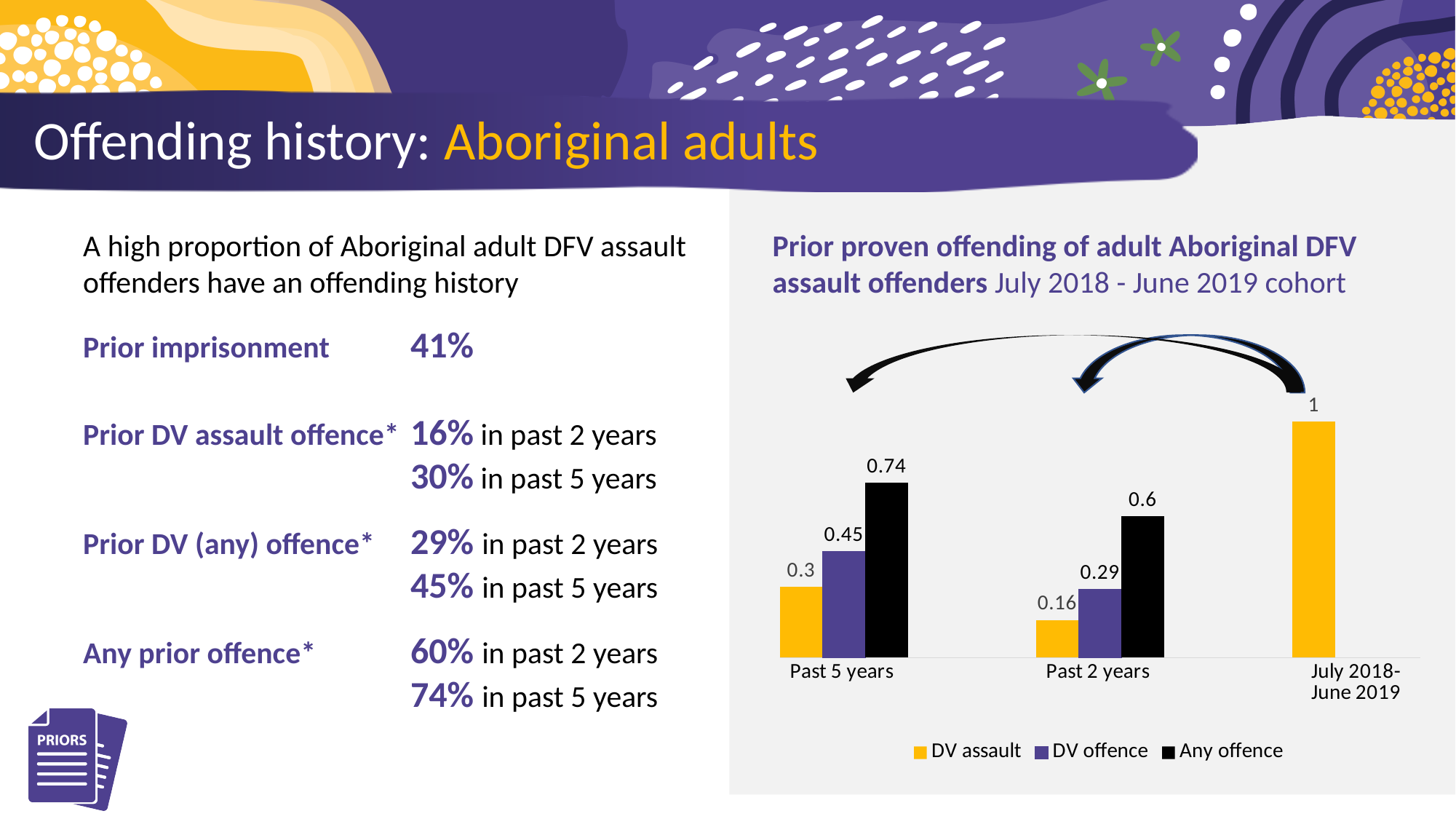
What colour represents the DV assault series in the chart? yellow Which is larger: DV offence in Past 5 years or Any offence in Past 2 years? Any offence in Past 2 years Which series has the highest value in the Past 2 years category? Any offence What is the value for DV assault in the Past 2 years category? 0.16 What is the value for DV offence in the Past 5 years category? 0.45 What is the difference between the Any offence values for Past 5 years and Past 2 years? 0.14 How many categories are shown on the x axis of the chart? 3 What is the value for Any offence in the Past 5 years category? 0.74 Which series has the lowest value in the Past 5 years category? DV assault How many series does the chart legend list? 3 What is the value for DV assault in the July 2018-June 2019 category? 1 What type of chart is shown on the slide? bar chart